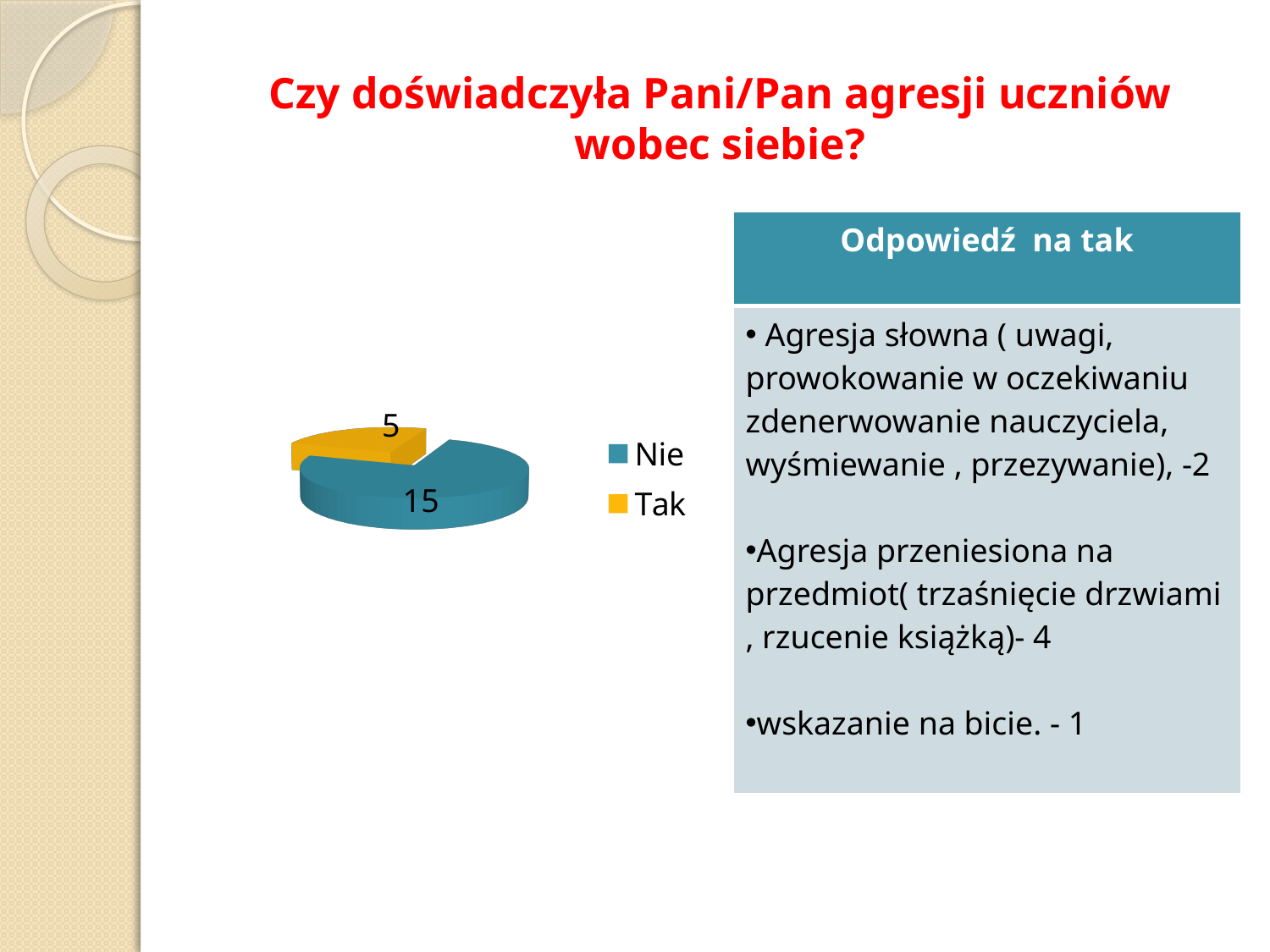
What share of the pie does the "Nie" slice represent? 75% Which category has the largest slice in the pie chart? Nie What is the value for "Tak" in the pie chart? 5 How many entries does the legend list? 2 What is the value for "Nie" in the pie chart? 15 How many categories does the pie chart show? 2 What share of the pie does the "Tak" slice represent? 25% What colour is the "Tak" slice in the pie chart? yellow/orange What is the difference between the values for "Nie" and "Tak"? 10 What kind of chart is shown on the slide? pie chart Which category has the smallest slice in the pie chart? Tak Which is larger, the value for "Nie" or the value for "Tak"? Nie